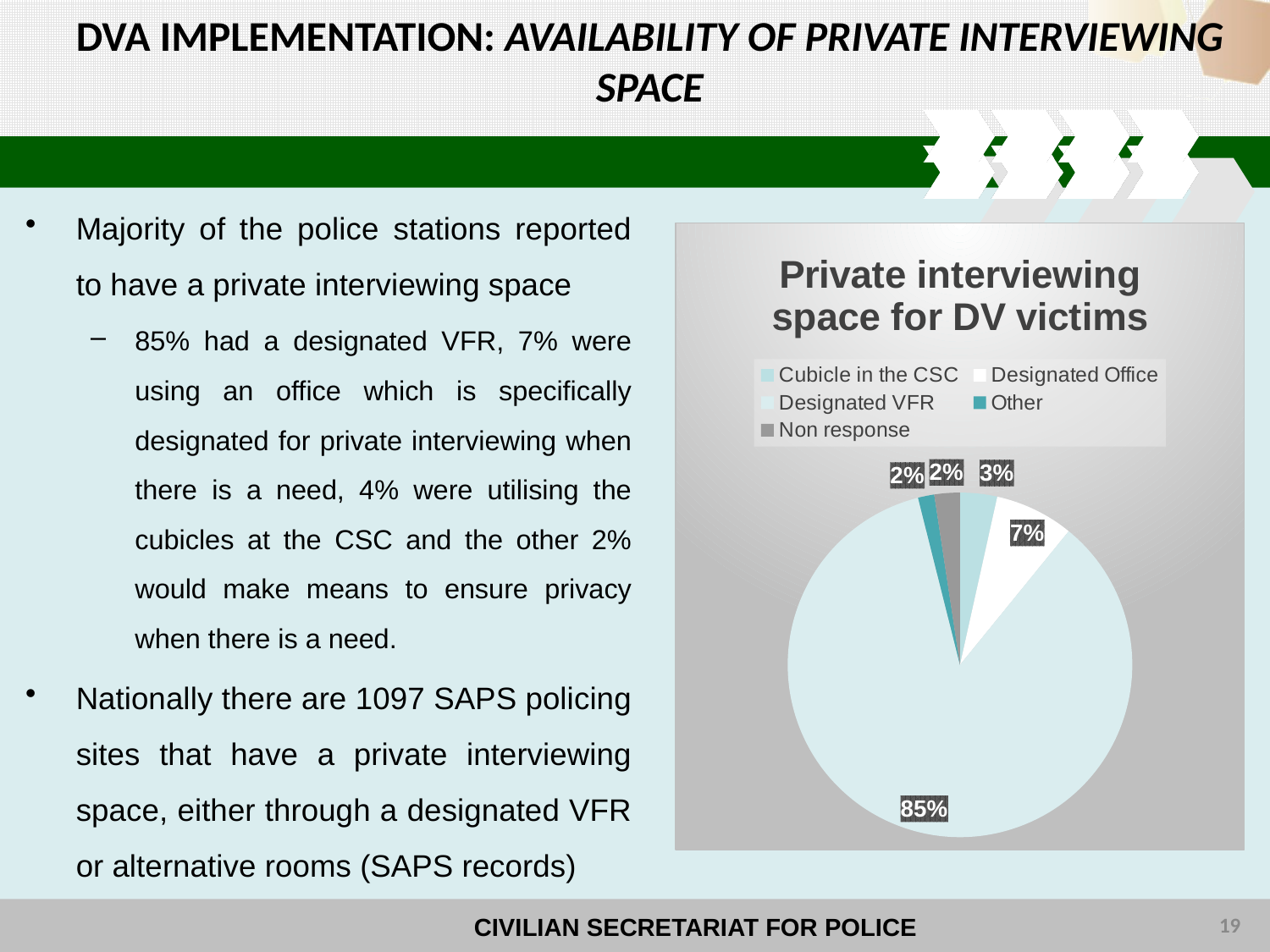
How many categories does the pie chart show? 5 What is the difference in percentage points between Designated VFR and Designated Office? 78% Which category has the largest slice of the pie? Designated VFR What percentage of the pie is labelled for Designated VFR? 85% What share of the pie does Designated VFR account for? 85% What percentage is shown for Cubicle in the CSC? 3% How many entries does the legend list? 5 What is the title of the chart? Private interviewing space for DV victims Which is larger, the slice for Designated Office or the slice for Cubicle in the CSC? Designated Office What type of chart is shown on the slide? pie chart What percentage is shown for the Non response slice? 2% What percentage is shown for Designated Office? 7%